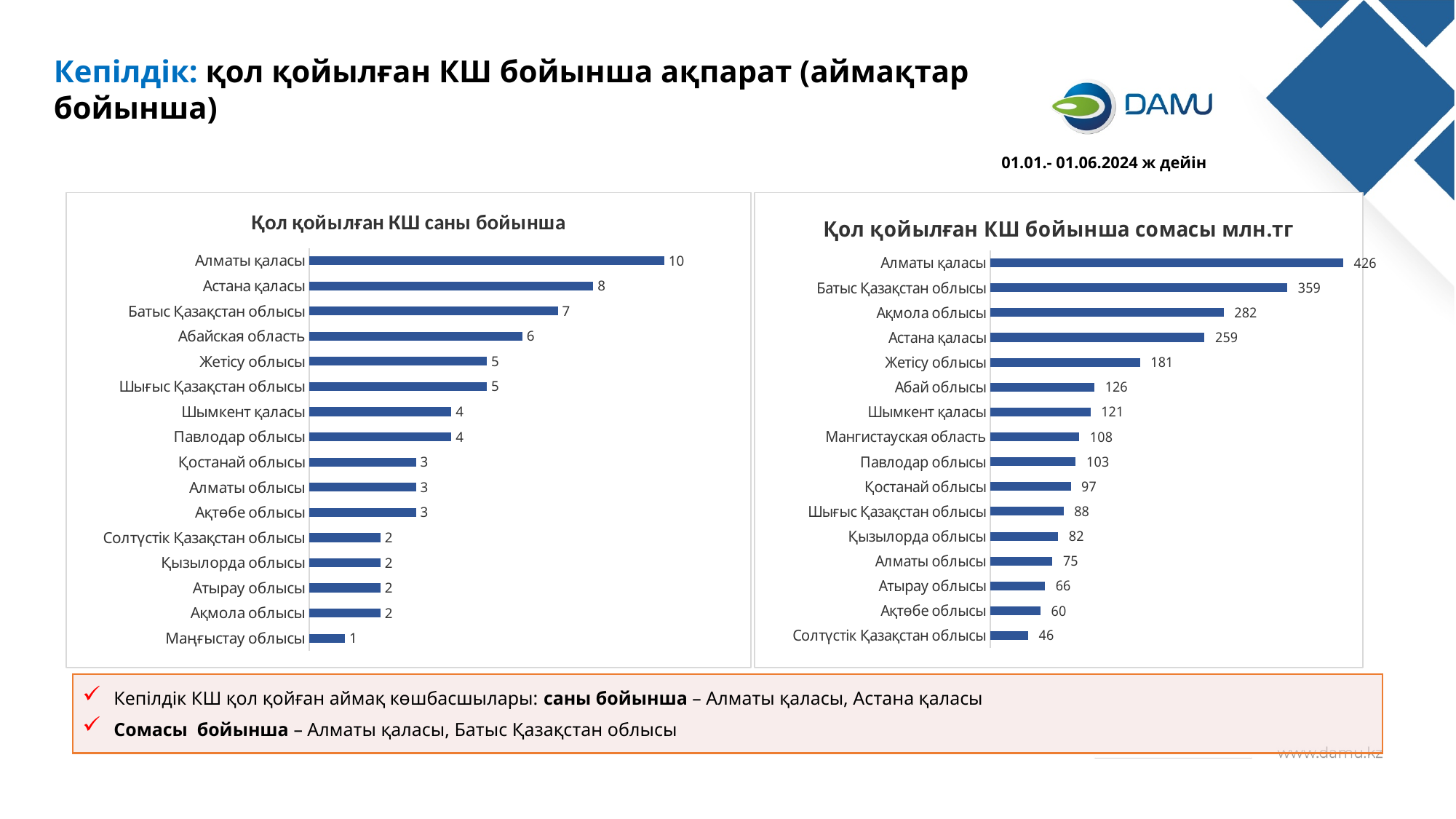
In the chart 'Қол қойылған КШ бойынша сомасы млн.тг', what is the value for Солтүстік Қазақстан облысы? 46 In the chart 'Қол қойылған КШ саны бойынша', how many categories are shown? 16 In the chart 'Қол қойылған КШ саны бойынша', which category has the lowest value? Маңғыстау облысы In the chart 'Қол қойылған КШ бойынша сомасы млн.тг', which category has the highest value? Алматы қаласы In the chart 'Қол қойылған КШ бойынша сомасы млн.тг', what is the difference between Алматы қаласы and Батыс Қазақстан облысы? 67 What type of chart is 'Қол қойылған КШ бойынша сомасы млн.тг'? Bar chart In the chart 'Қол қойылған КШ бойынша сомасы млн.тг', what is the value for Ақмола облысы? 282 What is the title of the left chart on the slide? Қол қойылған КШ саны бойынша In the chart 'Қол қойылған КШ бойынша сомасы млн.тг', which is larger: Жетісу облысы or Абай облысы? Жетісу облысы In the chart 'Қол қойылған КШ саны бойынша', what is the value for Астана қаласы? 8 In the chart 'Қол қойылған КШ саны бойынша', what is the value for Абайская область? 6 In the chart 'Қол қойылған КШ саны бойынша', what is the difference between Алматы қаласы and Батыс Қазақстан облысы? 3